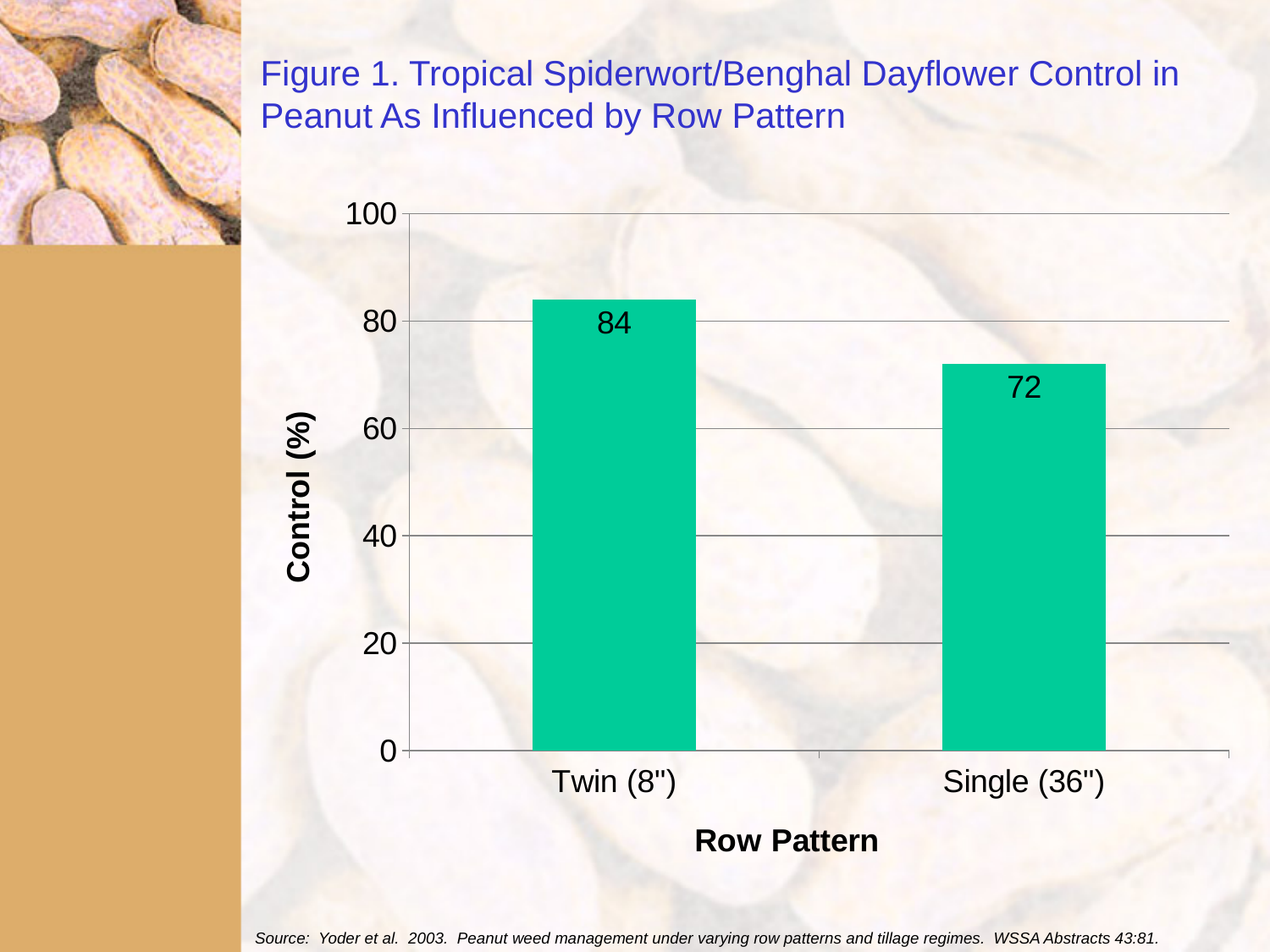
What is the difference in control (%) between the Twin (8") and Single (36") row patterns? 12 How many row pattern categories are shown in the chart? 2 What is the control (%) for the Single (36") row pattern? 72 What is the label of the y-axis? Control (%) Which has a larger control value, Twin (8") or Single (36")? Twin (8") What is the control (%) for the Twin (8") row pattern? 84 Which row pattern has the lowest control (%)? Single (36") Which row pattern has the highest control (%)? Twin (8") Is the control value for Twin (8") greater or less than 80? greater Is the control value for Single (36") greater or less than 80? less What kind of chart is shown on the slide? Bar chart What is the label of the x-axis? Row Pattern